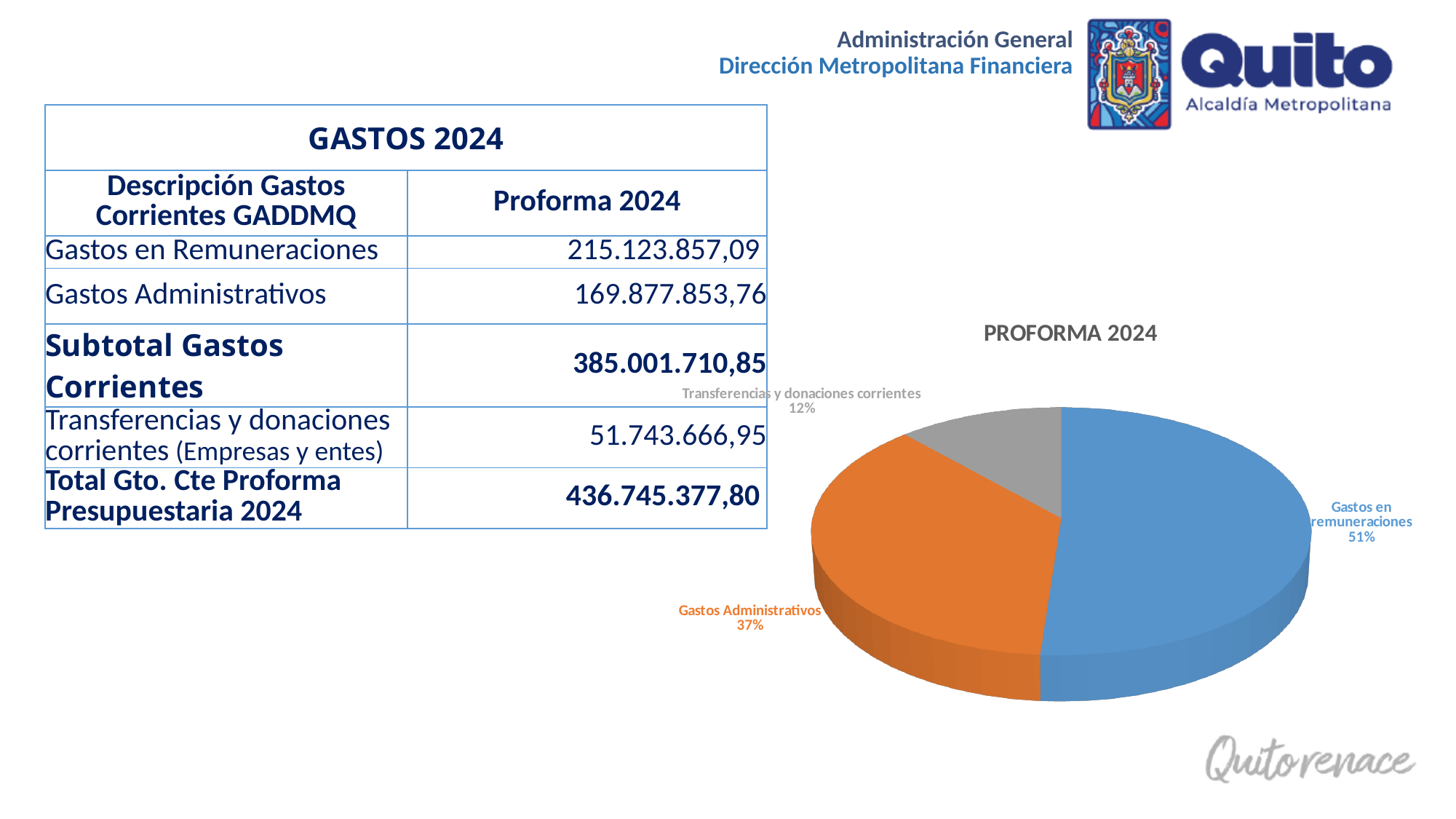
Which is larger in the pie chart, Gastos Administrativos or Transferencias y donaciones corrientes? Gastos Administrativos Which slice of the pie chart is the smallest? Transferencias y donaciones corrientes How many slices does the pie chart have? 3 What share of the pie does Gastos Administrativos represent? 37% What is the combined share of Gastos Administrativos and Transferencias y donaciones corrientes in the pie chart? 49% What share of the pie does Gastos en remuneraciones represent? 51% Which slice of the pie chart is the largest? Gastos en remuneraciones What type of chart is shown on the slide? pie chart What colour is the Gastos Administrativos slice in the pie chart? orange What share of the pie does Transferencias y donaciones corrientes represent? 12% What is the difference in percentage points between Gastos en remuneraciones and Gastos Administrativos? 14 What is the title of the pie chart? PROFORMA 2024